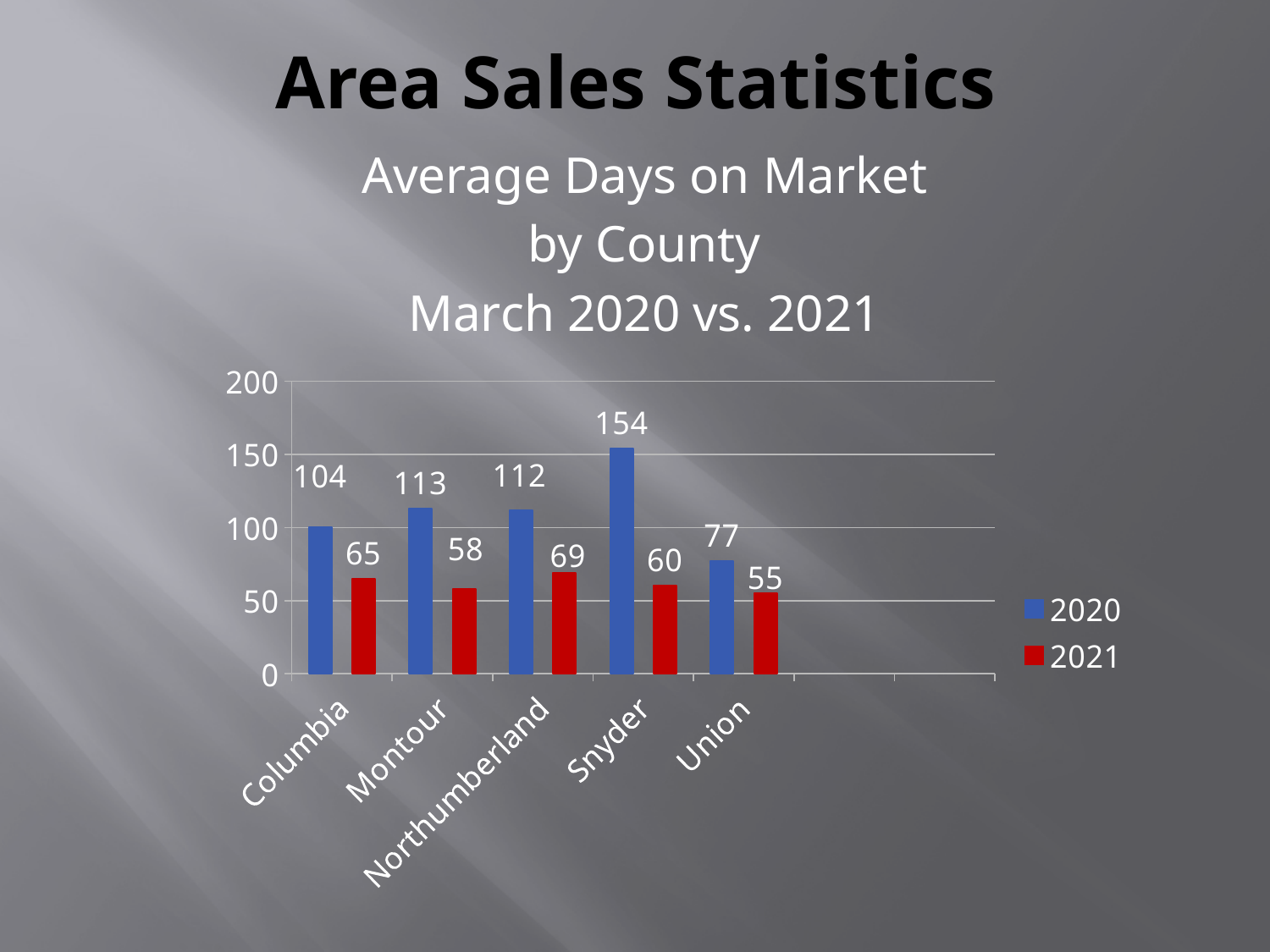
What is the difference between the 2020 values for Montour and Columbia? 9 Which county has the highest average days on market in 2020? Snyder What is the difference between the 2020 and 2021 values for Snyder? 94 Which colour represents the 2021 series in the legend? Red What is the average days on market for Montour in 2021? 58 What is the average days on market for Snyder in 2020? 154 What kind of chart is shown on the slide? Bar chart What is the value for Union in 2020? 77 How many series does the legend list? 2 How many counties are shown on the x axis? 5 Which county has the lowest average days on market in 2021? Union Which is larger, the 2021 value for Northumberland or the 2021 value for Columbia? Northumberland